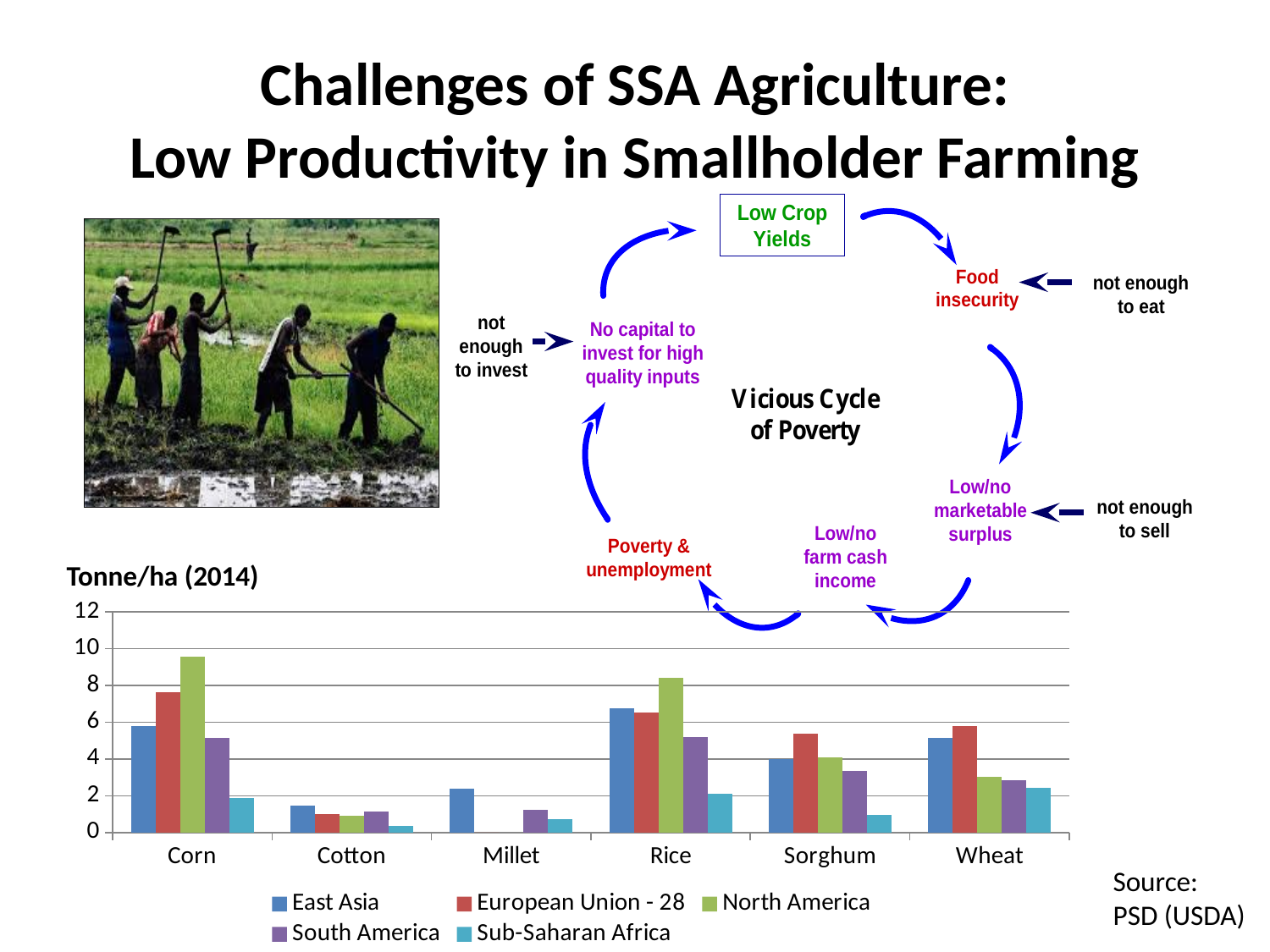
Which region has the highest yield for Rice in the bar chart? North America How many series does the legend of the bar chart list? 5 Is the Wheat yield for European Union - 28 greater or less than 4 tonne/ha? greater For Wheat, which has the larger yield: European Union - 28 or North America? European Union - 28 Which region has the highest yield for Corn in the bar chart? North America What kind of chart is shown at the bottom of the slide? bar chart For Corn, which has the larger yield: East Asia or European Union - 28? European Union - 28 Which region has the lowest yield for Sorghum in the bar chart? Sub-Saharan Africa What is the title (unit label) shown above the bar chart? Tonne/ha (2014) Is the Sorghum yield for Sub-Saharan Africa greater or less than 2 tonne/ha? less How many crop categories are shown on the x axis of the bar chart? 6 Is the Corn yield for North America greater or less than 8 tonne/ha? greater